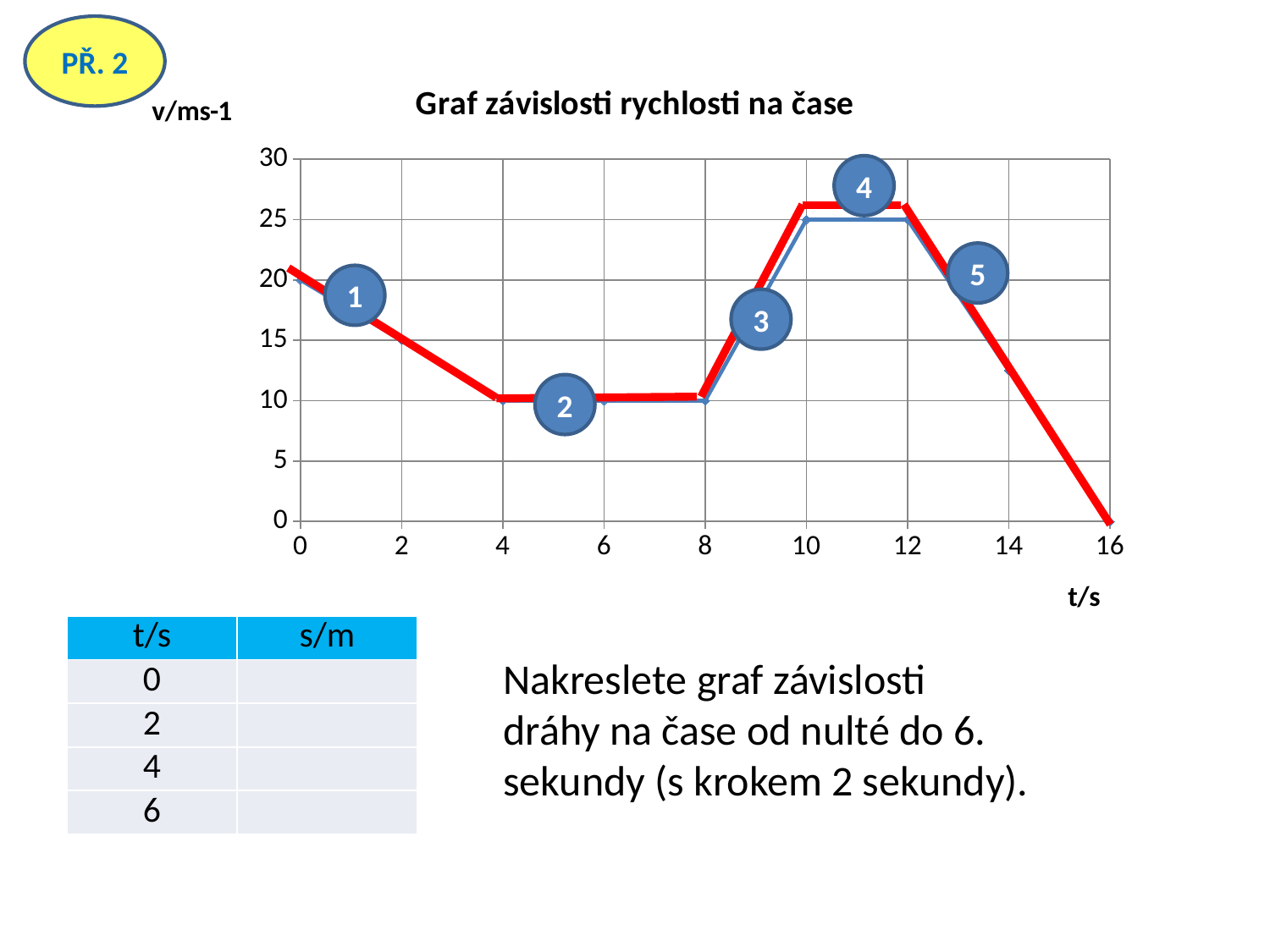
What is the title of the chart? Graf závislosti rychlosti na čase Which is larger, the velocity at t = 0 s or at t = 10 s? t = 10 s At which time does the velocity reach its lowest value? 16 What is the velocity value at t = 4 s? 10 What is the highest velocity value reached on the chart? 25 What kind of chart is shown on the slide? line chart What is the velocity value at t = 0 s? 20 Is the velocity at t = 14 s greater or less than 15? less What is the velocity value at t = 16 s? 0 What is the difference between the velocity at t = 10 s and at t = 8 s? 15 What is the velocity value at t = 10 s? 25 Does the velocity rise, fall or stay constant between t = 12 s and t = 16 s? fall